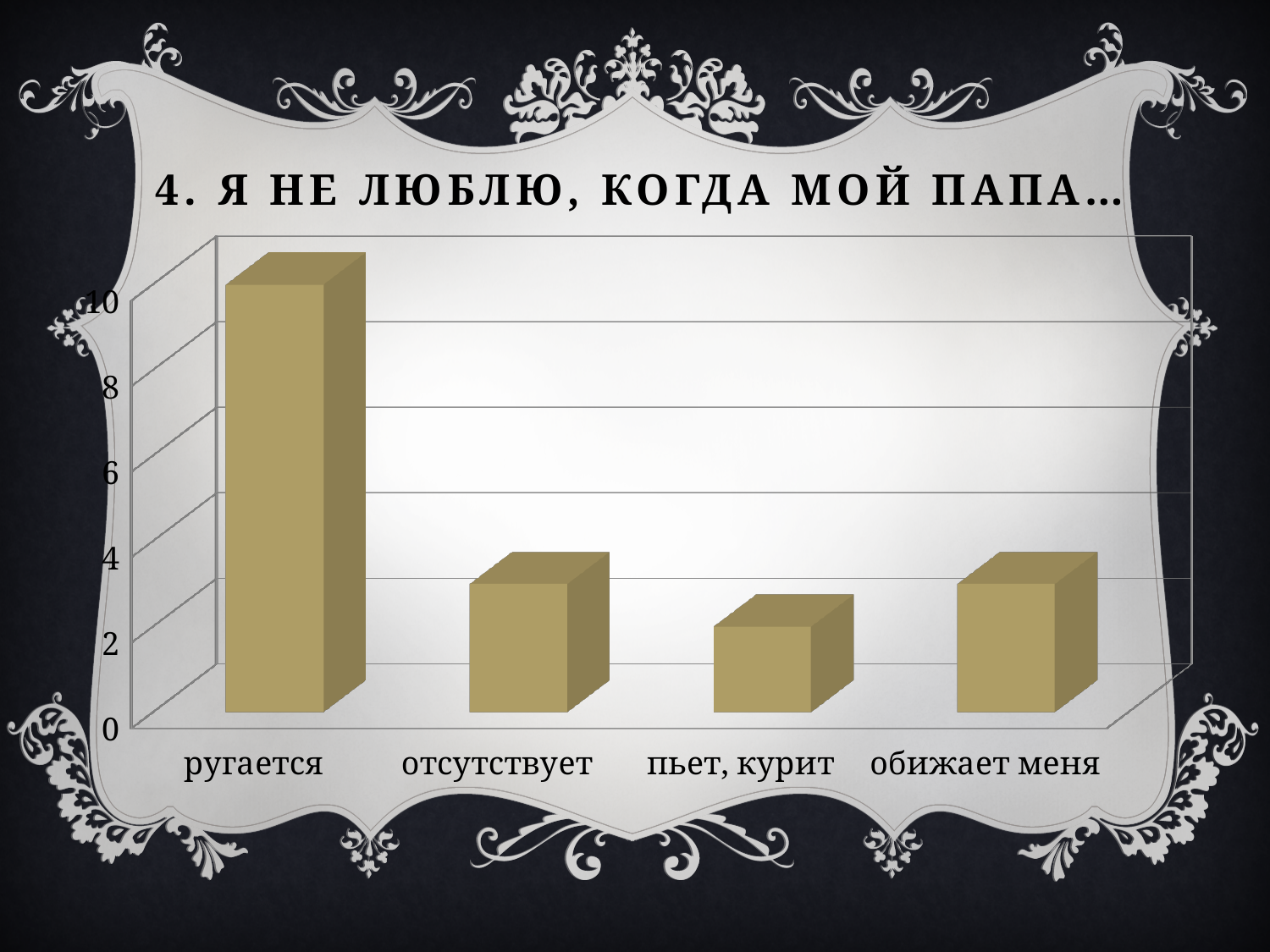
How many categories are shown on the chart? 4 Is the value for отсутствует greater or less than 4? less Which category has the lowest value? пьет, курит Which category has the highest value? ругается Which is larger, the value for пьет, курит or the value for ругается? ругается Which is larger, the value for ругается or the value for отсутствует? ругается What kind of chart is shown on the slide? bar chart What is the highest value shown on the vertical axis? 10 Is the value for пьет, курит greater or less than 4? less What is the title of the chart? 4. Я НЕ ЛЮБЛЮ, КОГДА МОЙ ПАПА… Is the value for обижает меня greater or less than 4? less